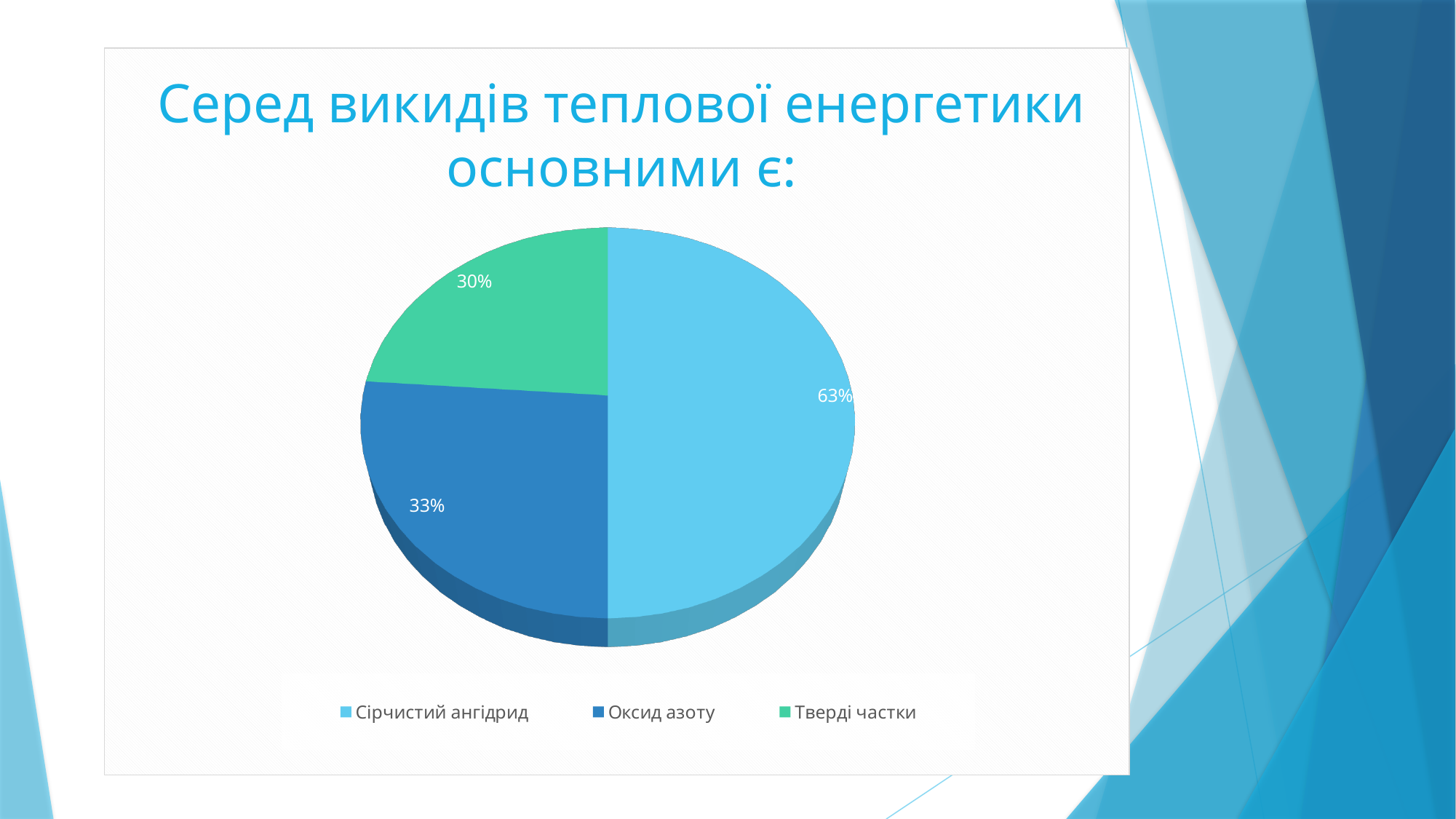
How many slices does the pie chart have? 3 How many entries does the legend list? 3 What is the difference between the labelled values for Сірчистий ангідрид and Оксид азоту? 30% What is the difference between the labelled values for Оксид азоту and Тверді частки? 3% What kind of chart is shown on the slide? Pie chart What percentage is shown for Тверді частки? 30% What percentage is shown for Оксид азоту? 33% Which category has the smallest slice of the pie? Тверді частки What percentage is shown for Сірчистий ангідрид? 63% Which category has the largest slice of the pie? Сірчистий ангідрид What colour is the slice for Тверді частки? Green Which is larger, the slice for Оксид азоту or the slice for Тверді частки? Оксид азоту